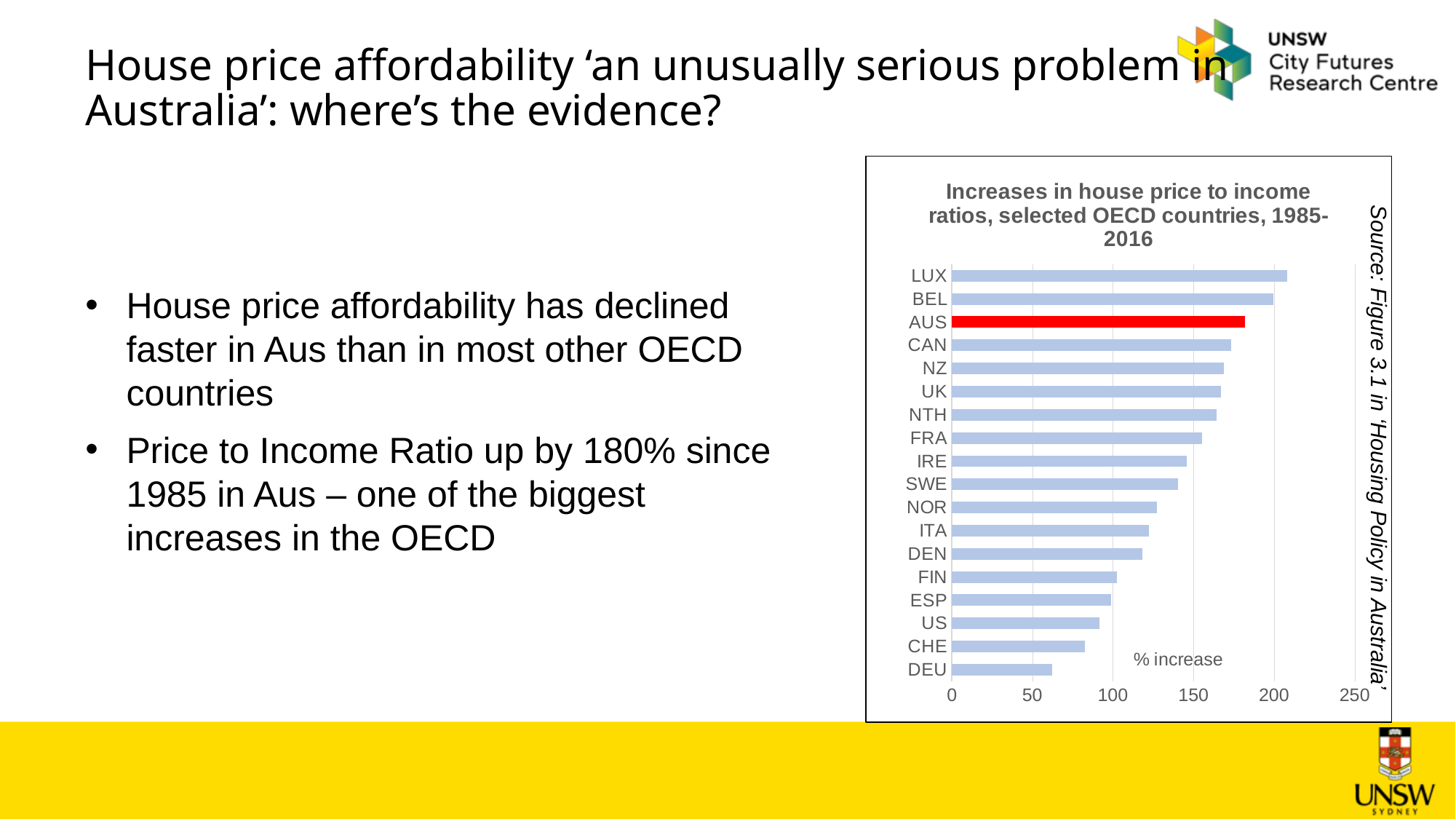
Which country's bar is highlighted in red in the chart? AUS What is the title of the chart? Increases in house price to income ratios, selected OECD countries, 1985-2016 Which country has the lowest increase in house price to income ratio in the chart? DEU Is the value for DEU greater or less than 100? less Which has the larger increase, AUS or CAN? AUS Which has the larger increase, SWE or NOR? SWE Is the value for NOR greater or less than 100? greater Is the value for LUX greater or less than 200? greater Which country has the highest increase in house price to income ratio in the chart? LUX What kind of chart is shown on the slide? Bar chart How many countries are shown in the chart? 18